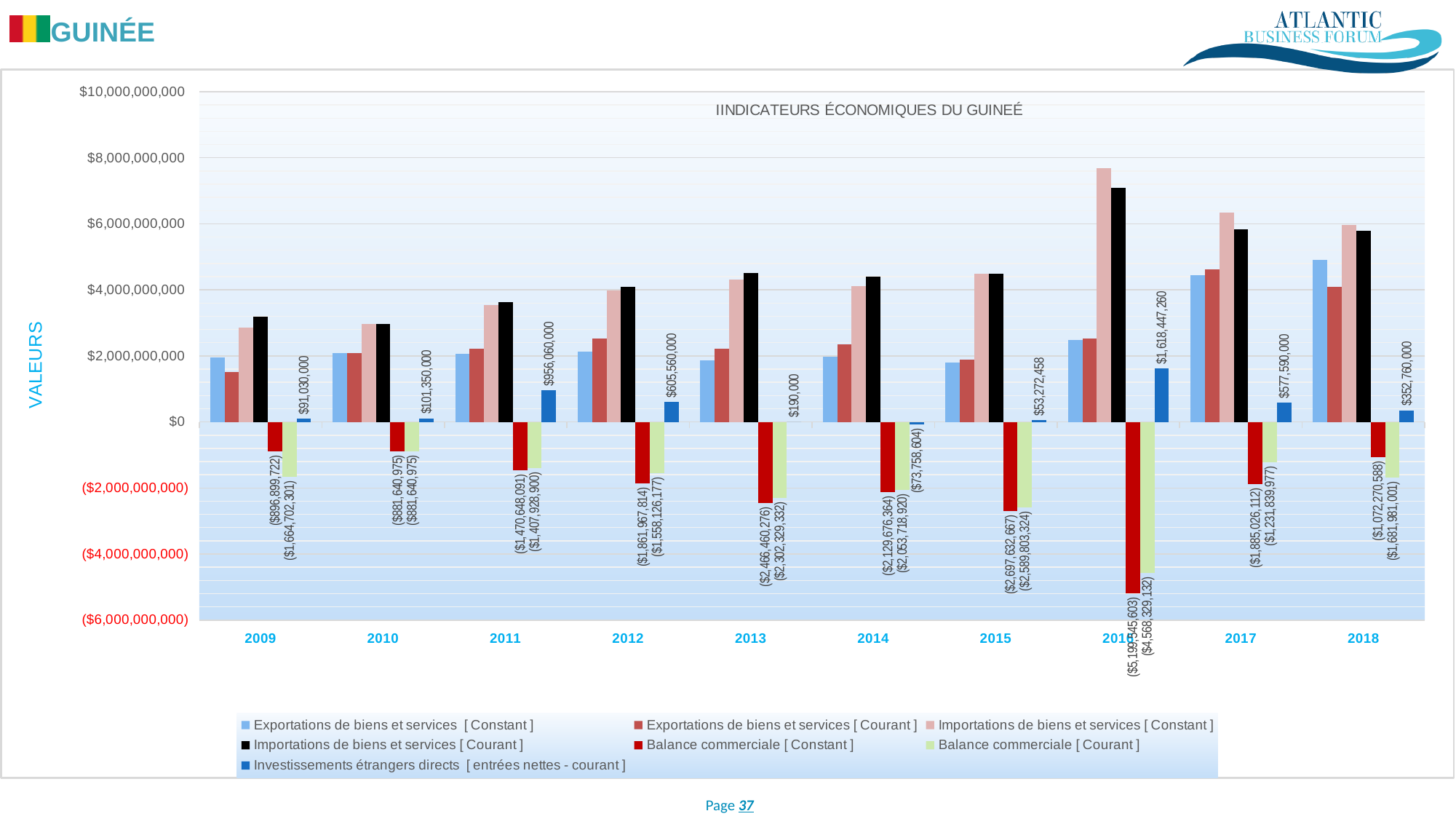
How many series does the legend list? 7 Which year has the larger value for Investissements étrangers directs [entrées nettes - courant], 2011 or 2012? 2011 Is the value for Importations de biens et services [Courant] in 2016 greater or less than $6,000,000,000? greater In which year is Investissements étrangers directs [entrées nettes - courant] highest? 2016 What is the value of Investissements étrangers directs [entrées nettes - courant] in 2011? $956,060,000 What is the value of Balance commerciale [Constant] in 2013? ($2,466,460,276) What kind of chart is shown on the slide? bar chart What is the difference between Investissements étrangers directs [entrées nettes - courant] in 2017 and in 2018? $224,830,000 What is the value of Investissements étrangers directs [entrées nettes - courant] in 2016? $1,618,447,260 In which year is Investissements étrangers directs [entrées nettes - courant] lowest? 2014 What is the value of Balance commerciale [Courant] in 2016? ($4,568,329,132) How many years are shown on the x axis? 10